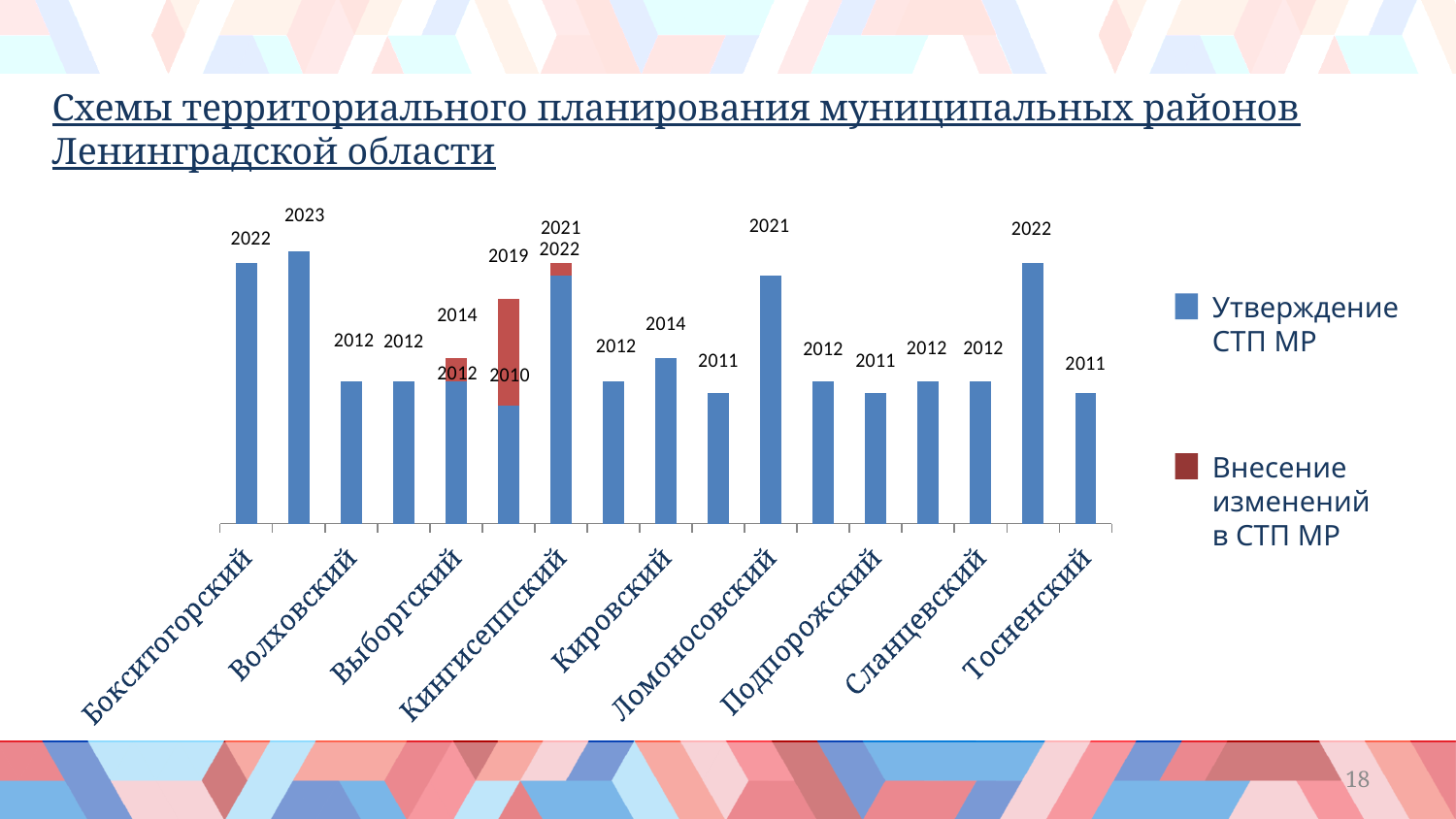
Which colour represents Внесение изменений в СТП МР in the chart? red What year is labelled on the bar for Тосненский? 2011 How many bars are plotted in the chart? 17 What year is labelled on the Внесение изменений в СТП МР segment for Кингисеппский? 2022 What kind of chart is shown on the slide? bar chart Which bar is taller, Бокситогорский or Волховский? Бокситогорский How many series does the legend list? 2 What year is labelled on the bar for Волховский? 2012 What year is labelled on the bar for Бокситогорский? 2022 What year is labelled on the Утверждение СТП МР segment for Выборгский? 2012 What year is labelled on the bar for Ломоносовский? 2021 What are the two legend entries of the chart? Утверждение СТП МР; Внесение изменений в СТП МР